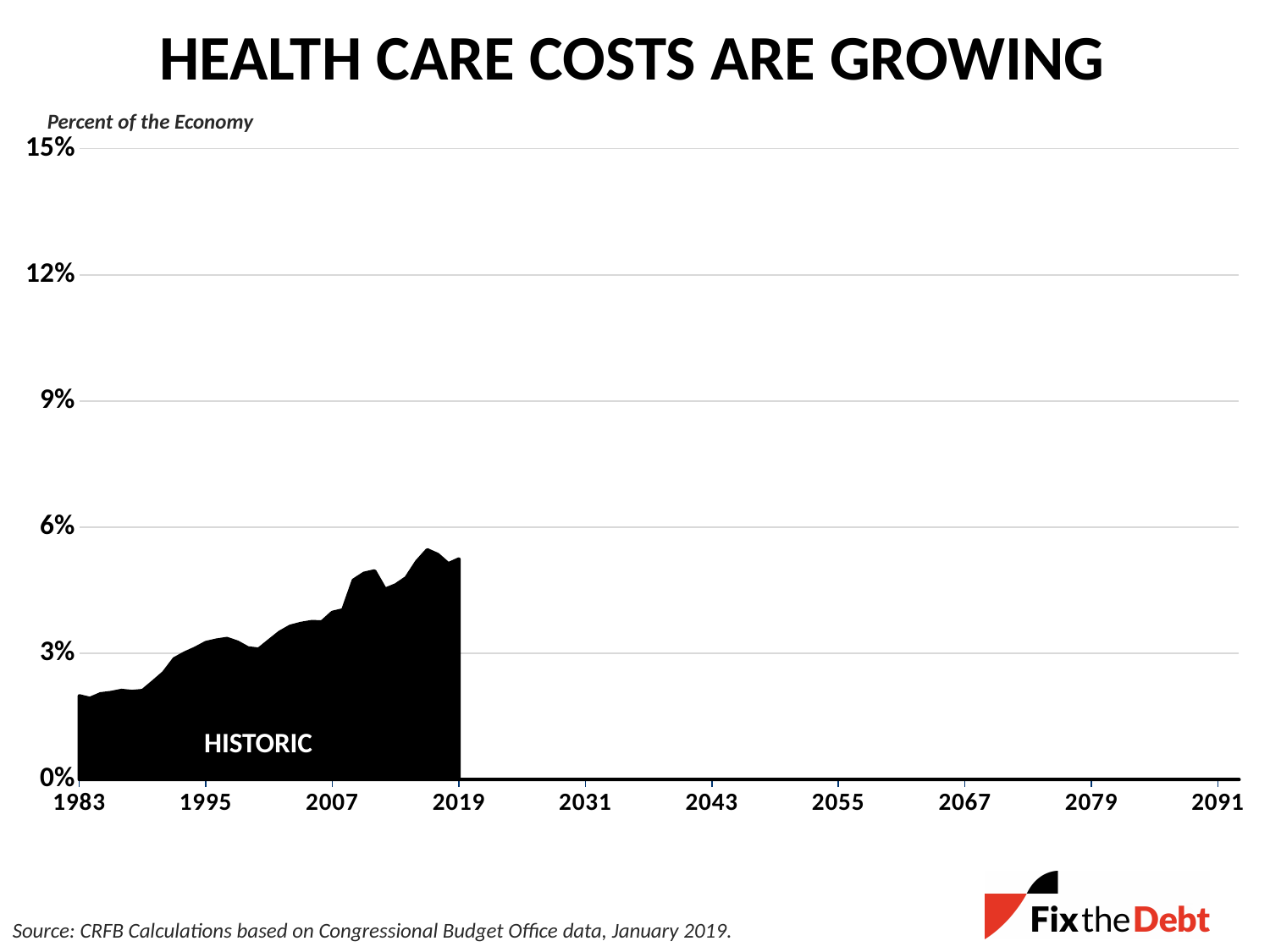
Is the value for 2019 greater or less than 3%? greater Is the value for 2019 greater or less than 6%? less What is the last year shown on the x axis? 2091 Which year has the larger value, 1983 or 2019? 2019 Is the value for 1983 greater or less than 3%? less What does the label above the y axis say the values are measured in? Percent of the Economy Do health care costs generally rise or fall from 1983 to 2019? rise In which year does the shaded historic data end? 2019 What kind of chart is shown on the slide? area chart What is the title of the chart? HEALTH CARE COSTS ARE GROWING What is the highest value shown on the y axis? 15%